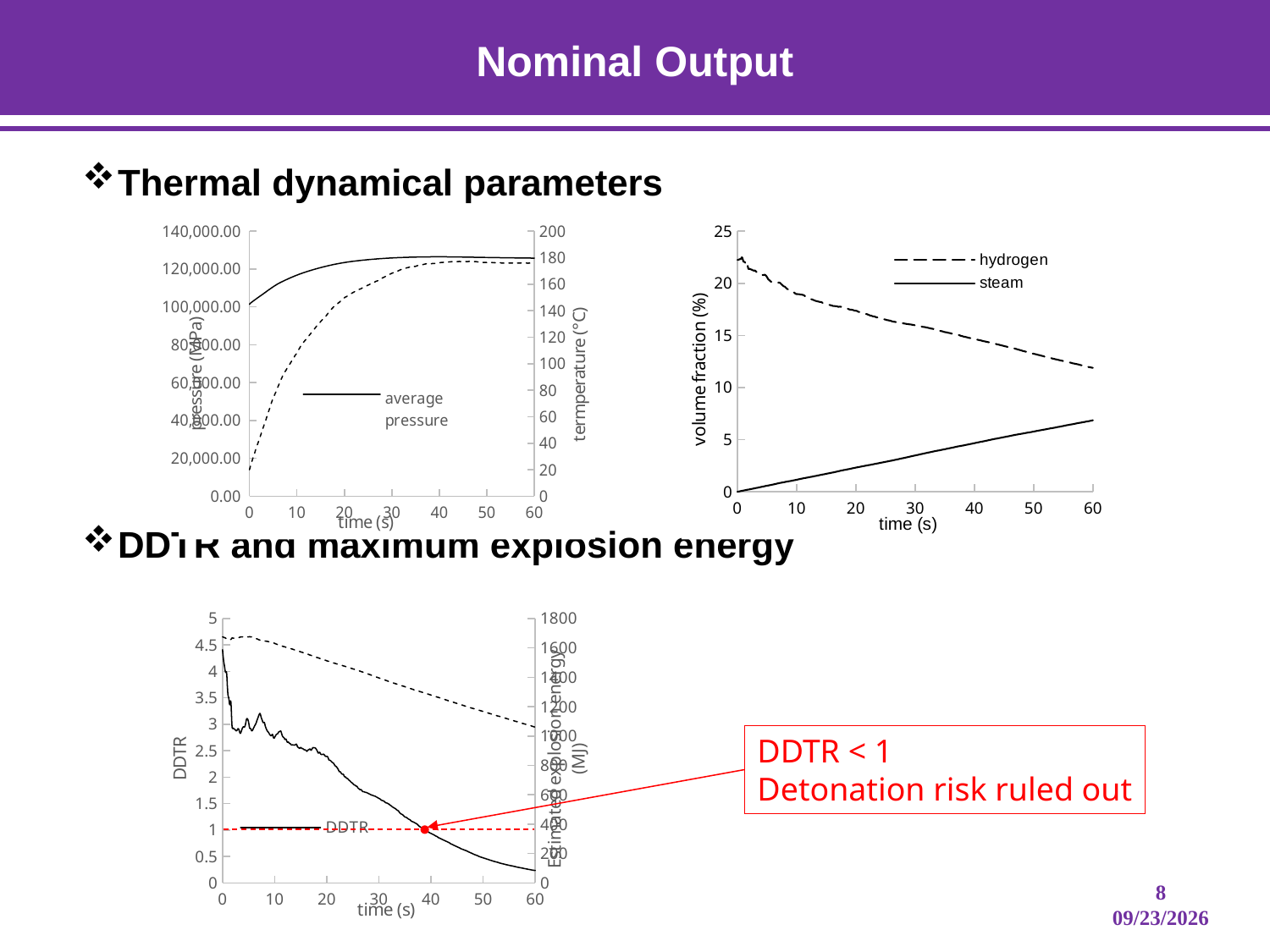
In the top-left chart (pressure and temperature vs time), does the average pressure rise or fall over the first 30 seconds? rise In the bottom chart (DDTR vs time), is the DDTR value at 60 s greater or less than 1? less In the top-left chart (pressure and temperature vs time), what kind of chart is it? line chart In the top-left chart (pressure and temperature vs time), is the average pressure at 0 s greater or less than 80,000.00? greater In the top-right chart (volume fraction vs time), how many series does the legend list? 2 In the bottom chart (DDTR vs time), is the DDTR value at 0 s greater or less than 4? greater In the bottom chart (DDTR vs time), does the DDTR value rise or fall as time increases? fall In the top-right chart (volume fraction vs time), at 60 s, which series has the larger volume fraction, hydrogen or steam? hydrogen In the top-right chart (volume fraction vs time), what are the two series named in the legend? hydrogen and steam In the top-right chart (volume fraction vs time), does the steam volume fraction rise or fall as time increases? rise